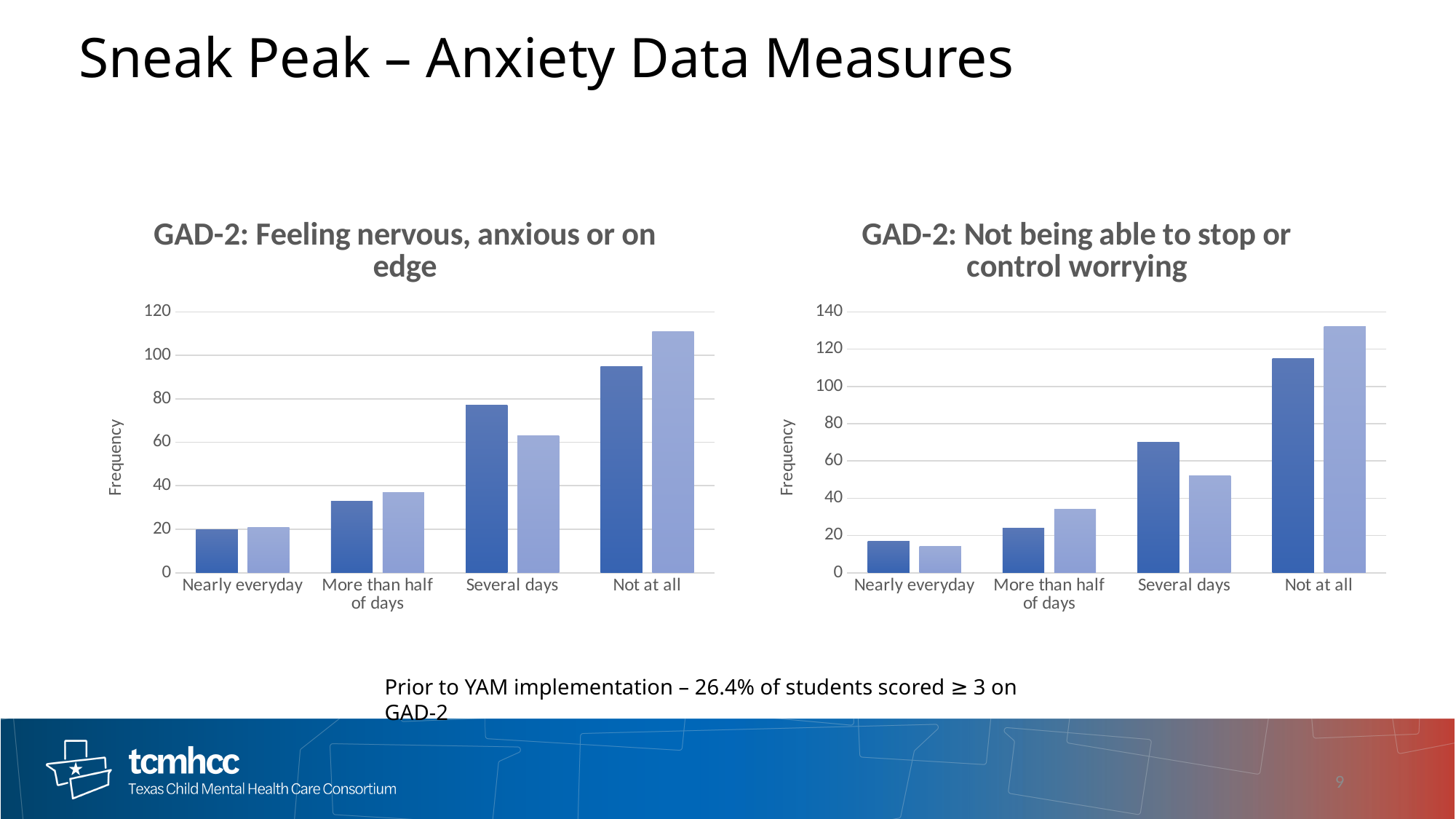
In the 'GAD-2: Feeling nervous, anxious or on edge' chart, which category has the tallest bars? Not at all In the 'GAD-2: Feeling nervous, anxious or on edge' chart, is the light blue bar for 'Several days' greater or less than 80? less What type of chart is the 'GAD-2: Feeling nervous, anxious or on edge' chart? Bar chart In the 'GAD-2: Feeling nervous, anxious or on edge' chart, is the dark blue bar for 'Not at all' greater or less than 80? greater In the 'GAD-2: Feeling nervous, anxious or on edge' chart, for 'Several days', which bar is taller: the dark blue or the light blue? Dark blue How many categories are shown on the x axis of the 'GAD-2: Not being able to stop or control worrying' chart? 4 In the 'GAD-2: Not being able to stop or control worrying' chart, for 'Not at all', which bar is taller: the dark blue or the light blue? Light blue In the 'GAD-2: Not being able to stop or control worrying' chart, do the bar heights generally rise or fall moving from 'Nearly everyday' to 'Not at all'? Rise In the 'GAD-2: Not being able to stop or control worrying' chart, is the light blue bar for 'Not at all' greater or less than 120? greater In the 'GAD-2: Not being able to stop or control worrying' chart, which category has the shortest bars? Nearly everyday What is the y-axis label on the 'GAD-2: Feeling nervous, anxious or on edge' chart? Frequency